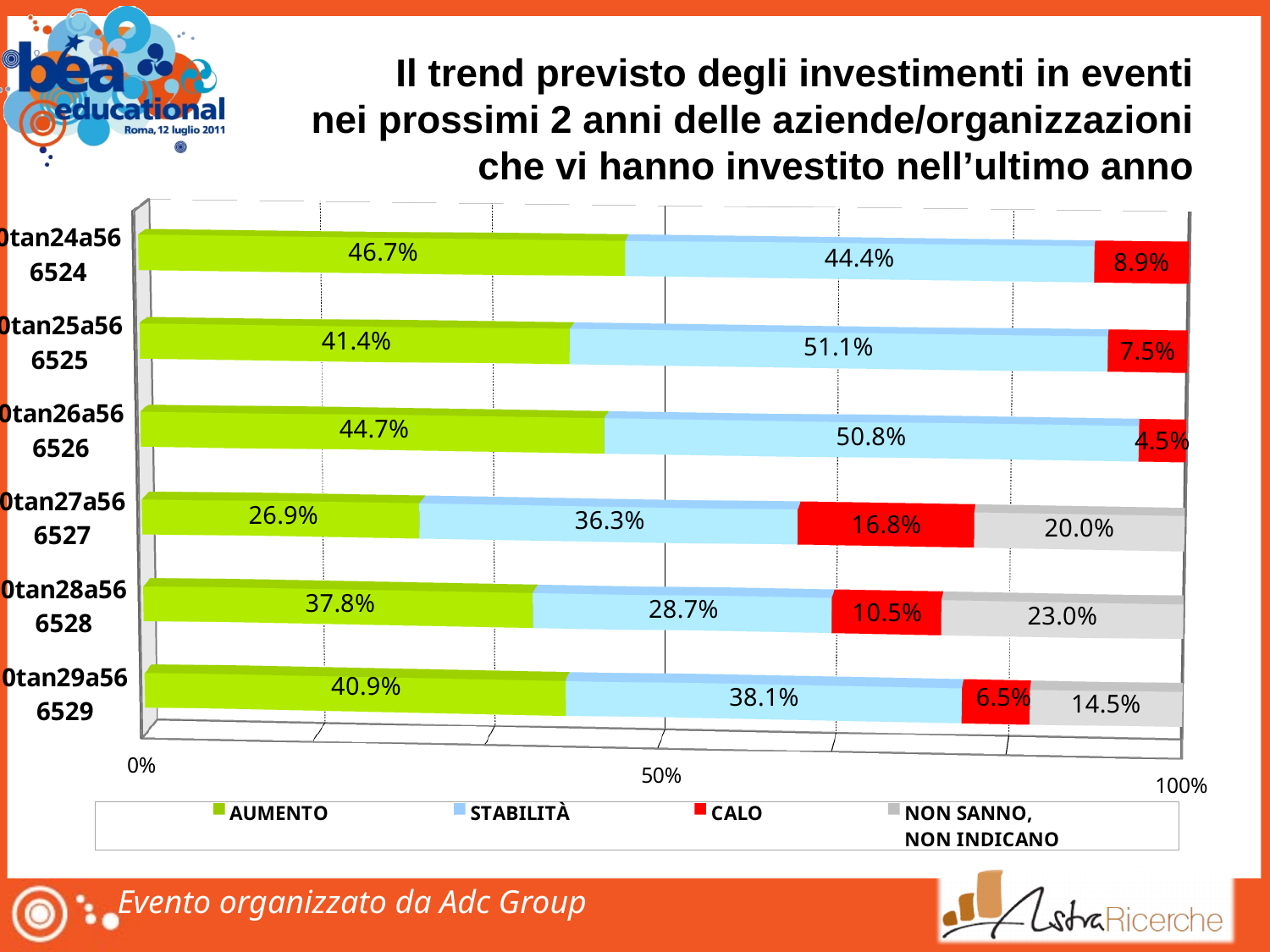
In the top bar (row ending in 6524), what is the difference between the AUMENTO and STABILITÀ values? 2.3 percentage points What is the NON SANNO, NON INDICANO value for the bottom bar (row ending in 6529)? 14.5% Which bar has the lowest AUMENTO value? The fourth bar from the top (row ending in 6527), 26.9% What kind of chart is shown on the slide? Stacked bar chart Which bar has the highest STABILITÀ value? The second bar from the top (row ending in 6525), 51.1% How many series does the legend list? 4 Which is larger: the NON SANNO, NON INDICANO value of the fifth bar (row ending in 6528) or that of the fourth bar (row ending in 6527)? The fifth bar (23.0%) What is the AUMENTO value for the top bar (row ending in 6524)? 46.7% How many bars (rows) are plotted in the chart? 6 What is the CALO value for the fourth bar from the top (row ending in 6527)? 16.8% What colour represents the CALO series in the legend? Red Which bar has the highest CALO value? The fourth bar from the top (row ending in 6527), 16.8%